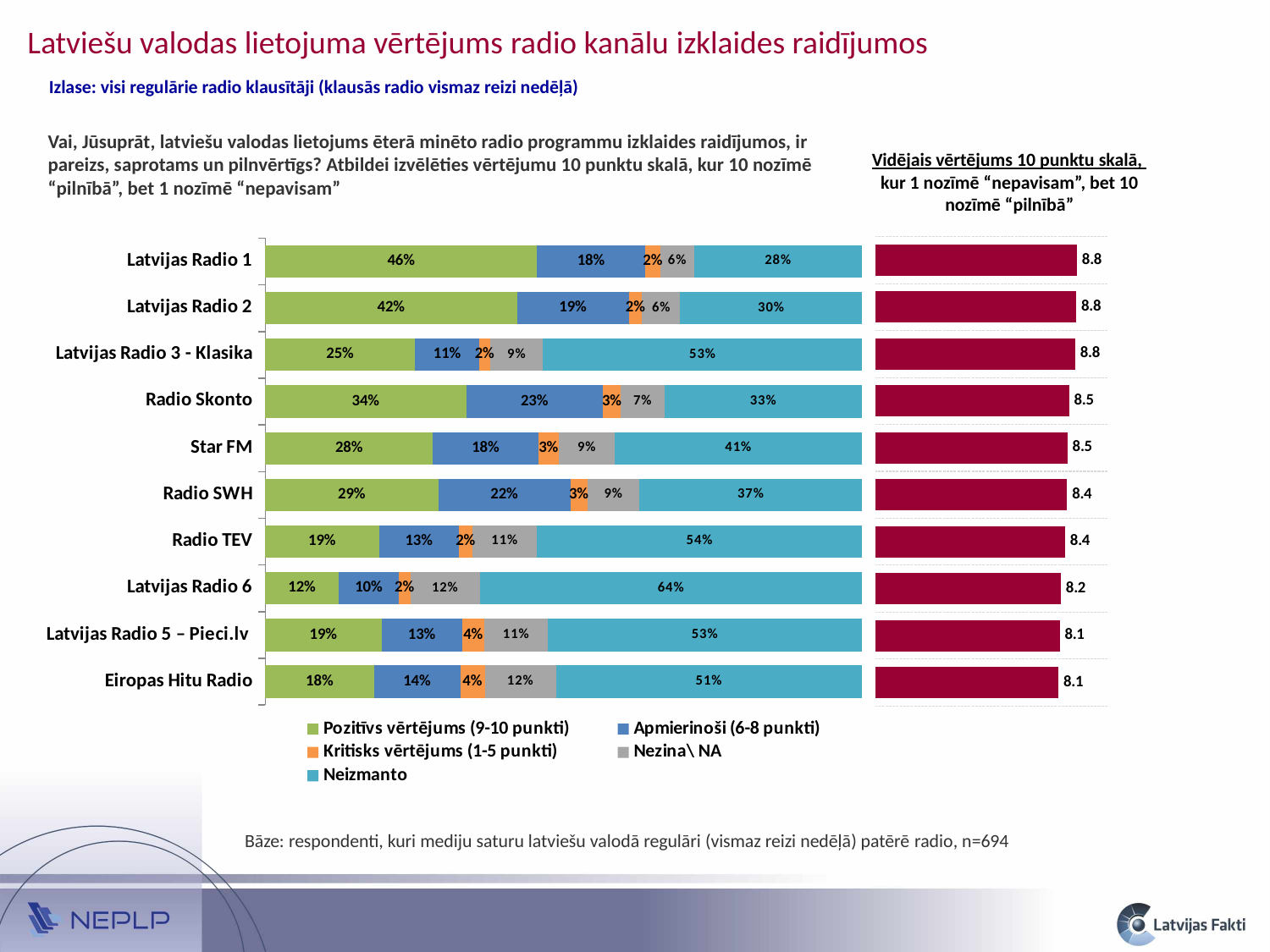
In the stacked bar chart on the left, what is the 'Neizmanto' share for Latvijas Radio 6? 64% In the stacked bar chart on the left, which is larger: the 'Apmierinoši (6-8 punkti)' share for Radio SWH or for Star FM? Radio SWH In the stacked bar chart on the left, what is the difference between the 'Neizmanto' shares of Radio TEV and Star FM? 13% What kind of chart is the chart on the left of the slide? Stacked bar chart In the stacked bar chart on the left, which station has the highest 'Pozitīvs vērtējums (9-10 punkti)' share? Latvijas Radio 1 In the stacked bar chart on the left, which station has the lowest 'Pozitīvs vērtējums (9-10 punkti)' share? Latvijas Radio 6 In the 'Vidējais vērtējums 10 punktu skalā' chart on the right, what is the average rating for Radio Skonto? 8.5 In the 'Vidējais vērtējums 10 punktu skalā' chart on the right, what is the difference between the average ratings of Latvijas Radio 1 and Eiropas Hitu Radio? 0.7 In the stacked bar chart on the left, what is the 'Pozitīvs vērtējums (9-10 punkti)' share for Latvijas Radio 1? 46% How many radio stations are shown in the stacked bar chart on the left? 10 In the stacked bar chart on the left, what is the 'Apmierinoši (6-8 punkti)' share for Radio Skonto? 23% How many series does the legend of the stacked bar chart on the left list? 5